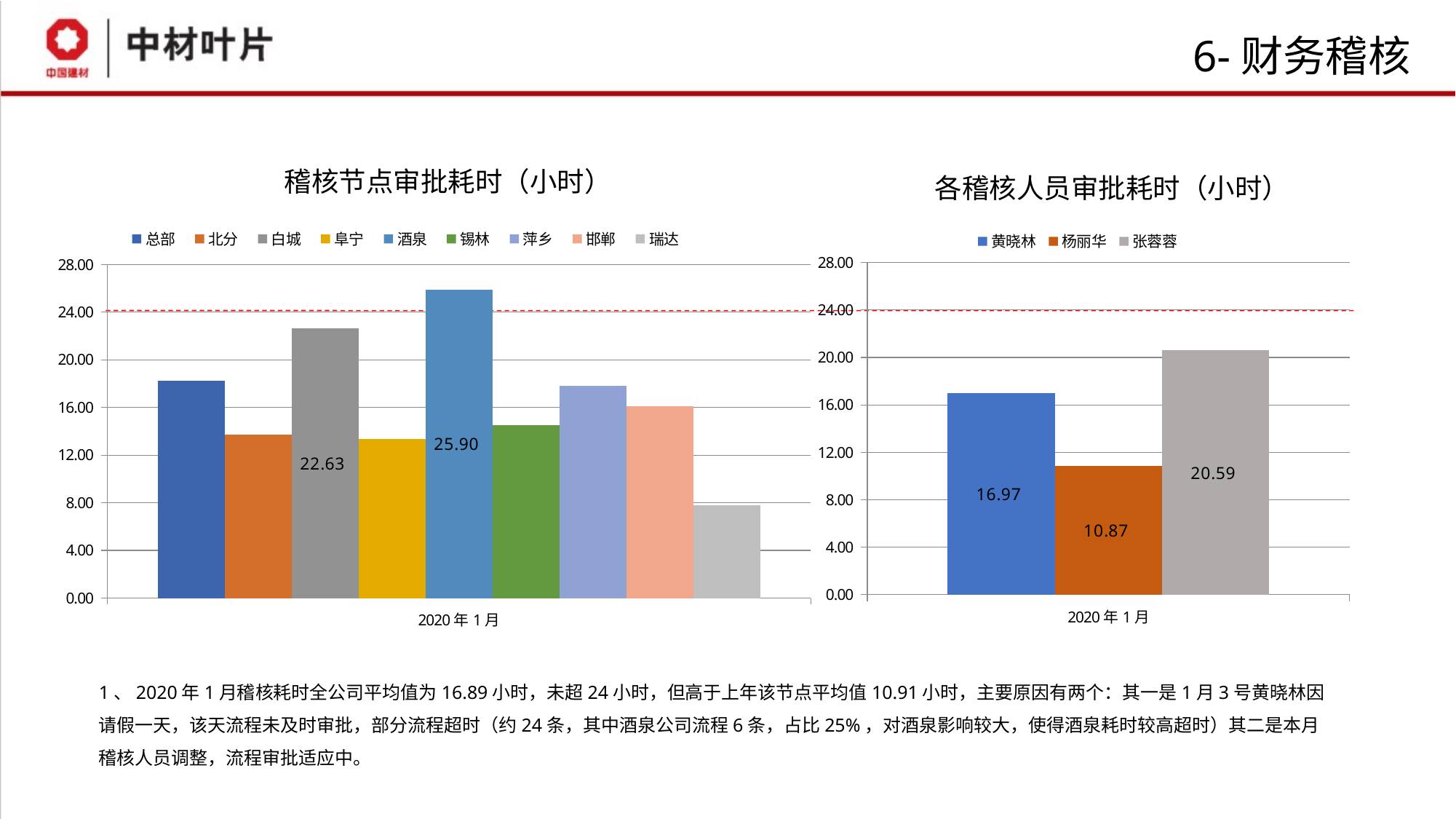
In the chart titled 稽核节点审批耗时（小时）, is the value for 总部 greater or less than 16.00? greater What kind of chart is the chart titled 各稽核人员审批耗时（小时）? bar chart In the chart titled 稽核节点审批耗时（小时）, which is larger, the value for 萍乡 or the value for 邯郸? 萍乡 In the chart titled 稽核节点审批耗时（小时）, what is the value for 白城? 22.63 In the chart titled 各稽核人员审批耗时（小时）, what is the value for 杨丽华? 10.87 In the chart titled 稽核节点审批耗时（小时）, what is the difference between the values for 酒泉 and 白城? 3.27 In the chart titled 稽核节点审批耗时（小时）, which series has the highest value? 酒泉 In the chart titled 各稽核人员审批耗时（小时）, what is the difference between the values for 张蓉蓉 and 黄晓林? 3.62 In the chart titled 稽核节点审批耗时（小时）, how many series does the legend list? 9 In the chart titled 稽核节点审批耗时（小时）, what is the value for 酒泉? 25.90 In the chart titled 稽核节点审批耗时（小时）, which series has the lowest value? 瑞达 In the chart titled 各稽核人员审批耗时（小时）, which person has the highest value? 张蓉蓉